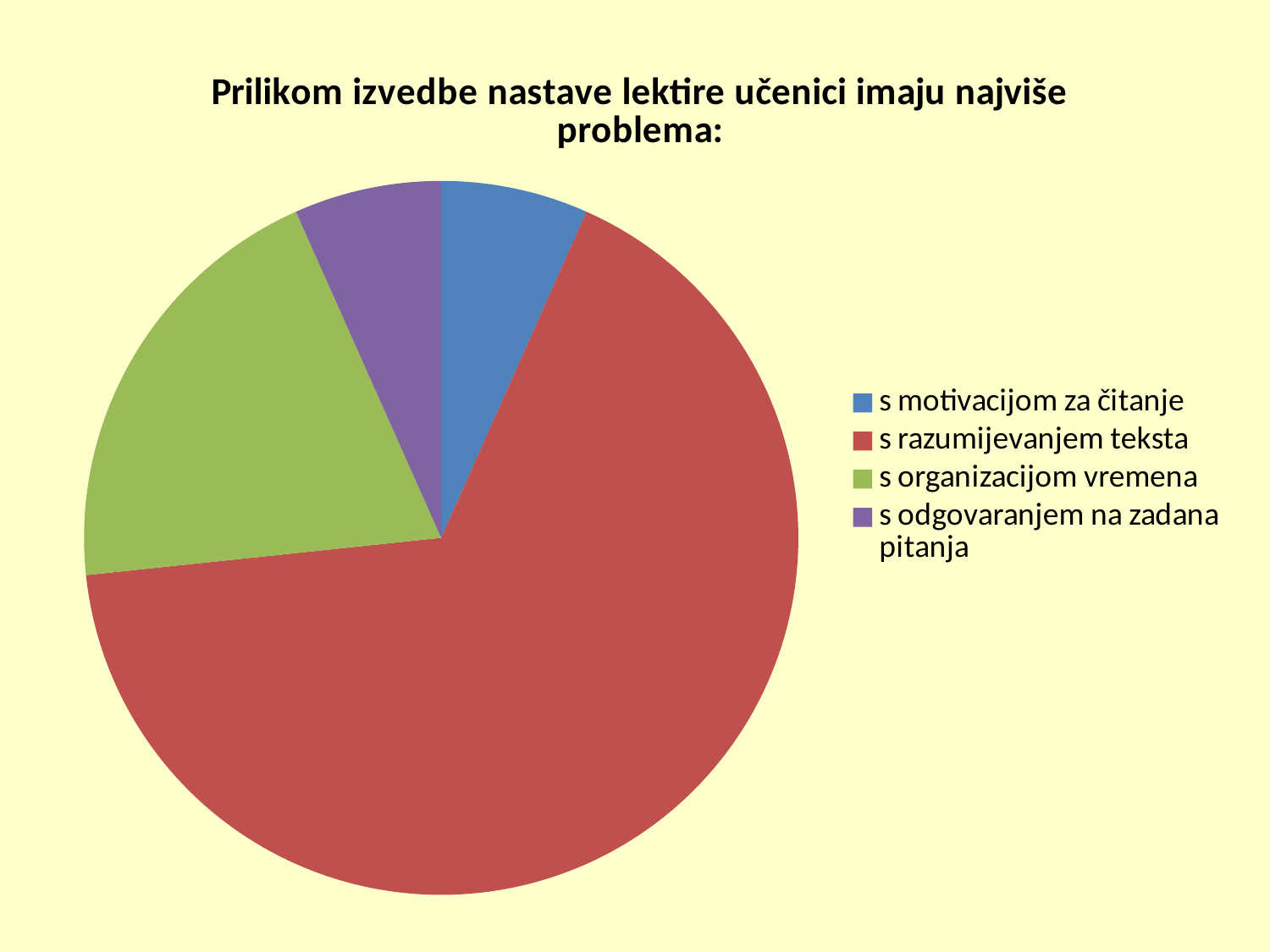
How many categories (slices) does the pie chart have? 4 Which category has the second largest slice of the pie? s organizacijom vremena Which category has the largest slice of the pie? s razumijevanjem teksta Which slice is larger: 's razumijevanjem teksta' or 's odgovaranjem na zadana pitanja'? s razumijevanjem teksta Which slice is larger: 's razumijevanjem teksta' or 's organizacijom vremena'? s razumijevanjem teksta How many entries does the legend list? 4 What kind of chart is shown on the slide? pie chart What colour is the slice for 's organizacijom vremena'? green Which slice is larger: 's organizacijom vremena' or 's motivacijom za čitanje'? s organizacijom vremena What is the title of the chart? Prilikom izvedbe nastave lektire učenici imaju najviše problema: